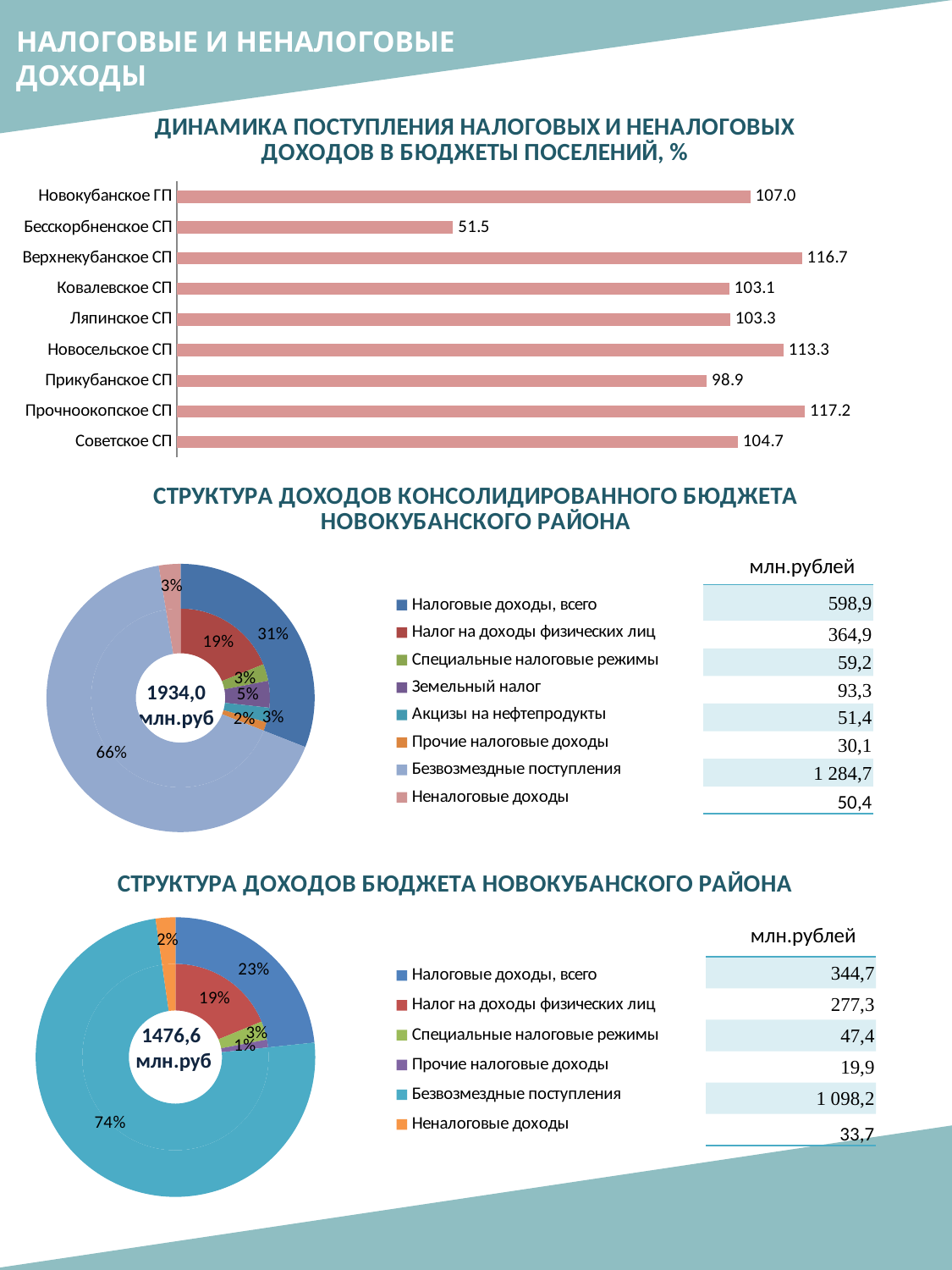
In the bar chart 'Динамика поступления налоговых и неналоговых доходов в бюджеты поселений, %', what is the value for Новокубанское ГП? 107.0 How many settlements are shown in the bar chart 'Динамика поступления налоговых и неналоговых доходов в бюджеты поселений, %'? 9 In the bar chart 'Динамика поступления налоговых и неналоговых доходов в бюджеты поселений, %', which is larger: Новосельское СП or Прикубанское СП? Новосельское СП In the chart 'Структура доходов бюджета Новокубанского района', what share do Безвозмездные поступления have? 74% In the bar chart 'Динамика поступления налоговых и неналоговых доходов в бюджеты поселений, %', what is the difference between Верхнекубанское СП and Бесскорбненское СП? 65.2 What type of chart is 'Динамика поступления налоговых и неналоговых доходов в бюджеты поселений, %'? bar chart In the chart 'Структура доходов консолидированного бюджета Новокубанского района', what share do Безвозмездные поступления have? 66% In the chart 'Структура доходов бюджета Новокубанского района', what total is shown in the centre of the doughnut? 1476,6 млн.руб In the chart 'Структура доходов консолидированного бюджета Новокубанского района', what is the value in млн.рублей for Налог на доходы физических лиц? 364,9 In the bar chart 'Динамика поступления налоговых и неналоговых доходов в бюджеты поселений, %', which settlement has the highest value? Прочноокопское СП In the bar chart 'Динамика поступления налоговых и неналоговых доходов в бюджеты поселений, %', which settlement has the lowest value? Бесскорбненское СП How many entries does the legend list in the chart 'Структура доходов консолидированного бюджета Новокубанского района'? 8